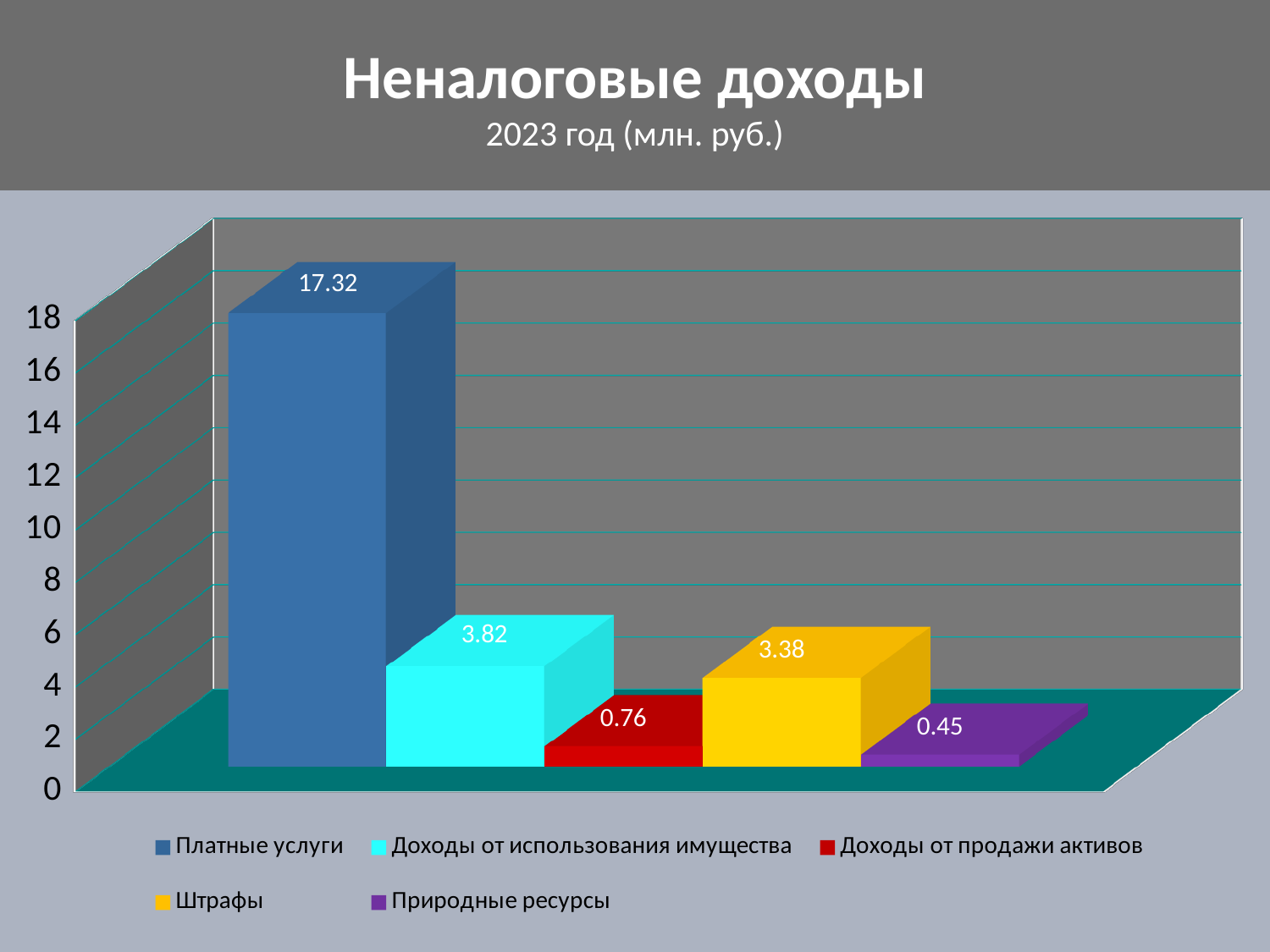
Which is larger, the value for Доходы от использования имущества or the value for Штрафы? Доходы от использования имущества How many categories are shown in the chart? 5 What is the difference between the values for Платные услуги and Доходы от использования имущества? 13.5 What is the value for Доходы от использования имущества? 3.82 What is the value for Природные ресурсы? 0.45 What is the value for Доходы от продажи активов? 0.76 What kind of chart is shown on the slide? Bar chart What is the title of the chart? Неналоговые доходы Which category has the highest value? Платные услуги What is the value for Штрафы? 3.38 Which category has the lowest value? Природные ресурсы What is the value for Платные услуги? 17.32